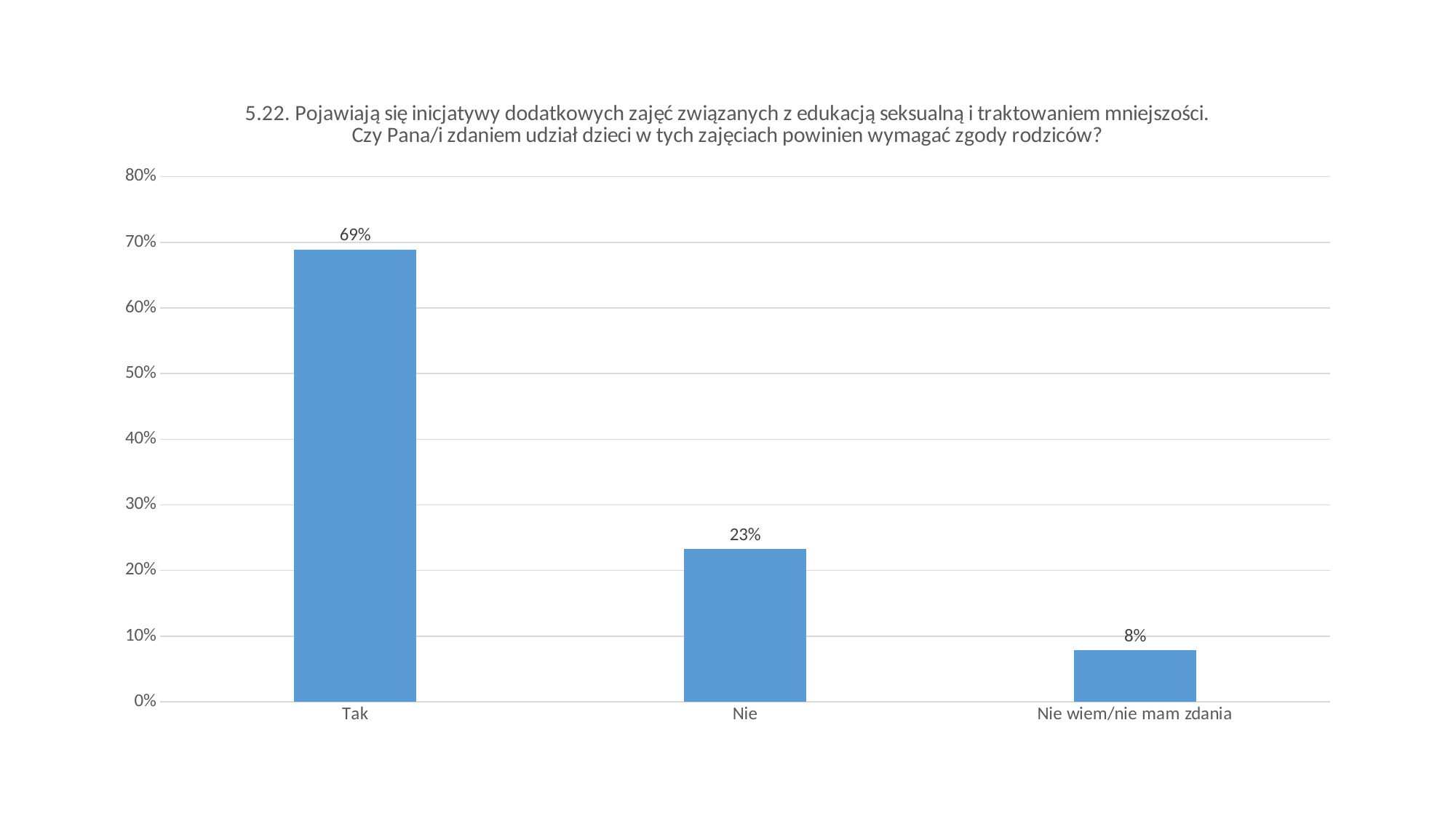
Which category has the lowest value? Nie wiem/nie mam zdania Which category has the highest value? Tak What is the value for "Tak"? 69% What is the value for "Nie"? 23% What is the value for "Nie wiem/nie mam zdania"? 8% Which is larger, the value for "Nie" or the value for "Nie wiem/nie mam zdania"? Nie What is the difference between the values for "Tak" and "Nie"? 46% What kind of chart is shown on the slide? bar chart What is the difference between the values for "Nie" and "Nie wiem/nie mam zdania"? 15% Do the values rise or fall from left to right along the x axis? fall Is the value for "Tak" greater or less than 60%? greater How many categories are shown on the x axis? 3